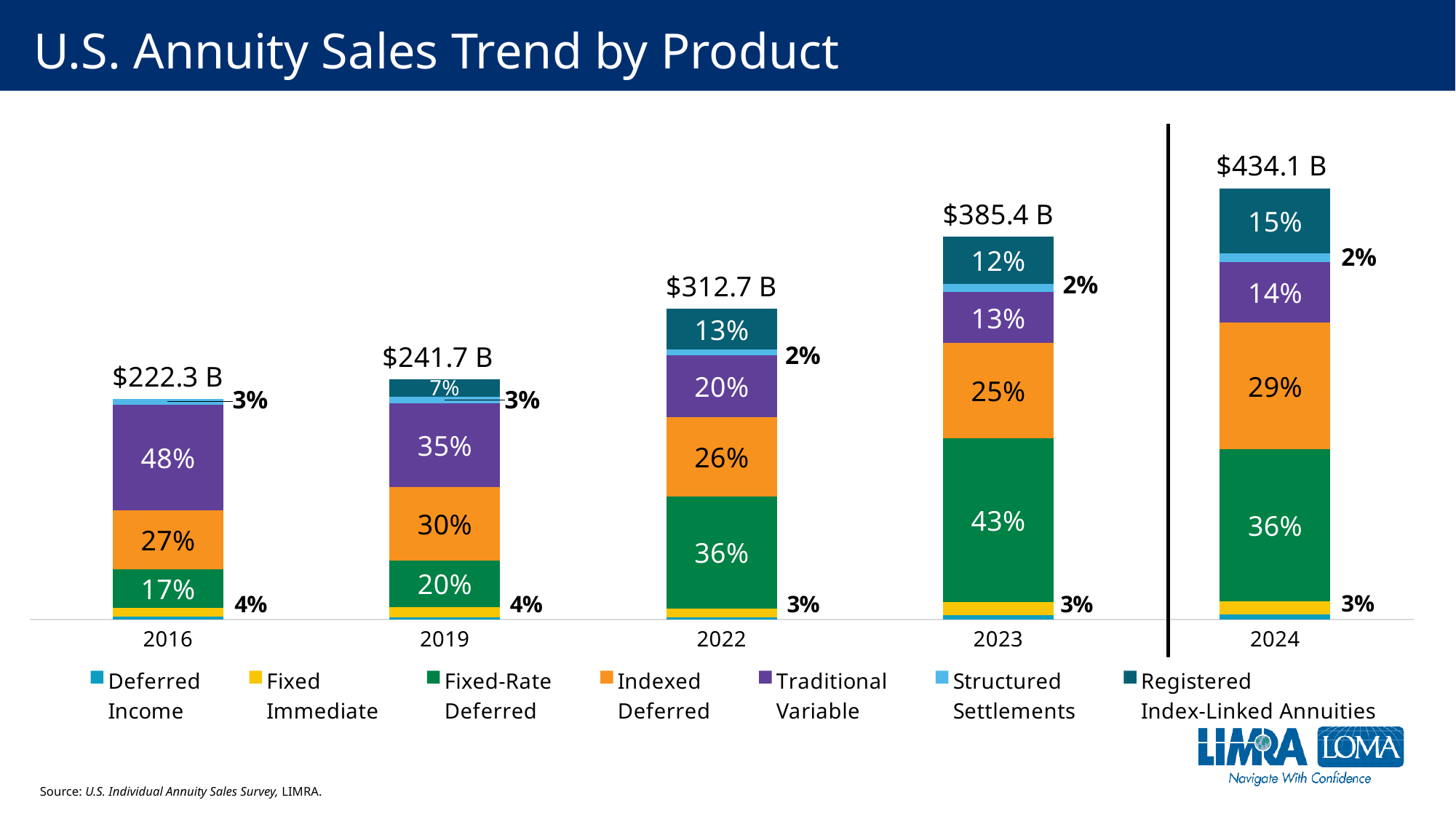
What kind of chart is shown on the slide? Stacked bar chart What is the total U.S. annuity sales value shown for 2016? $222.3 B Which year has the lowest total annuity sales? 2016 How many years are shown along the x axis? 5 What share of 2023 sales is Fixed-Rate Deferred? 43% What share of 2024 sales is Registered Index-Linked Annuities? 15% What is the total U.S. annuity sales value shown for 2024? $434.1 B Do total annuity sales rise or fall from 2016 to 2024? Rise Which year has the highest total annuity sales? 2024 What share of 2016 sales is Traditional Variable? 48% What is the difference between the total sales in 2024 and 2023? $48.7 B How many series does the legend list? 7